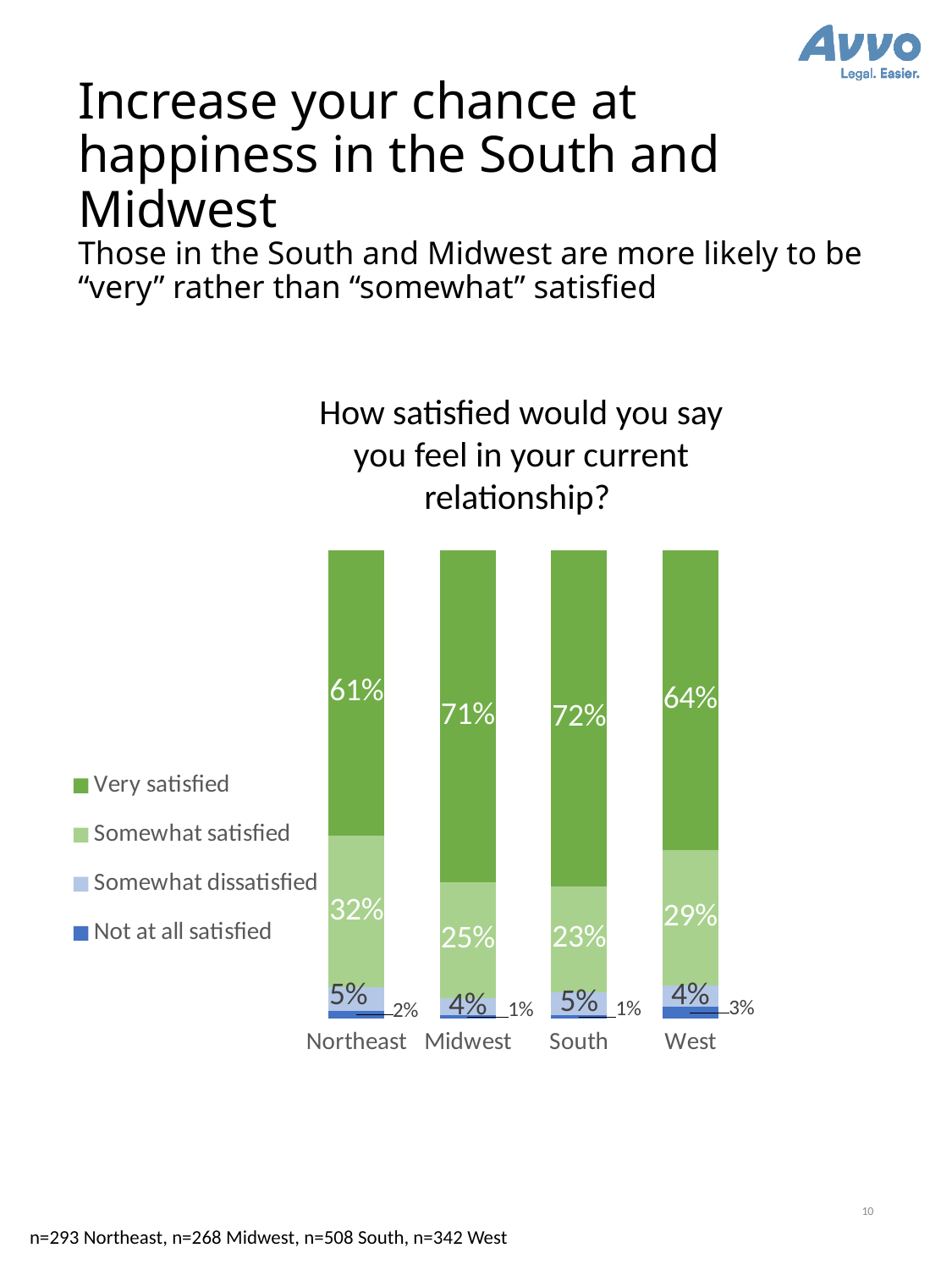
What is the "Not at all satisfied" value for the West? 3% What is the title of the chart? How satisfied would you say you feel in your current relationship? How many regions are shown on the x axis of the chart? 4 Which region has a larger "Somewhat satisfied" share, the Midwest or the West? West Which region has the highest "Very satisfied" percentage? South How many series does the chart legend list? 4 What is the "Somewhat satisfied" value for the Northeast? 32% What is the "Somewhat dissatisfied" value for the Midwest? 4% Which region has the lowest "Very satisfied" percentage? Northeast How much higher is the "Very satisfied" percentage in the South than in the Northeast? 11 percentage points What percentage of respondents in the South are "Very satisfied"? 72% What kind of chart is shown on the slide? Stacked bar chart